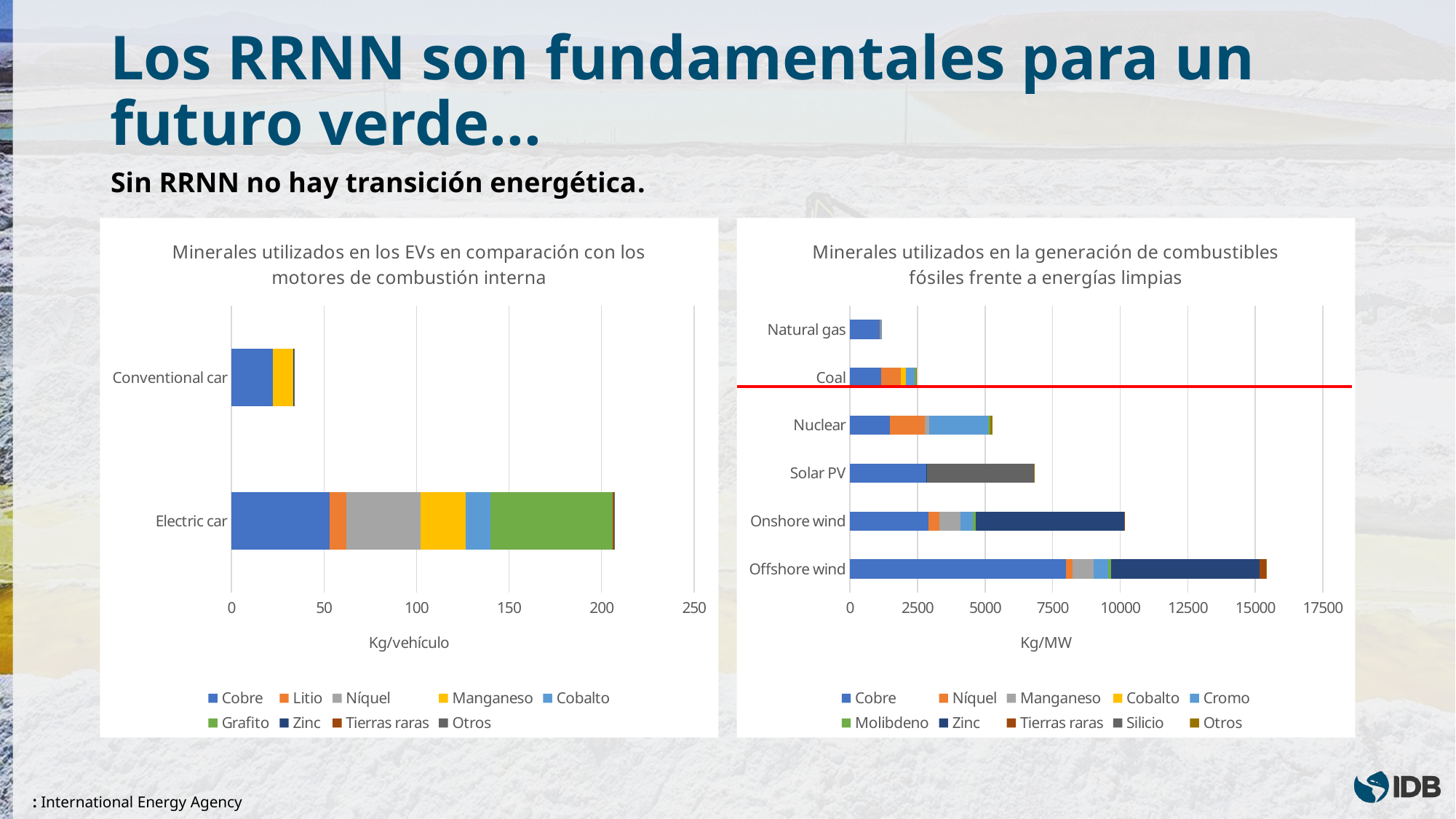
What kind of chart is the left chart, 'Minerales utilizados en los EVs en comparación con los motores de combustión interna'? Bar chart In the left chart, is the total value for Conventional car greater or less than 50? less In the left chart, which category has the larger total bar? Electric car In the right chart, how many series does the legend list? 10 In the left chart, is the total value for Electric car greater or less than 150? greater In the left chart, how many series does the legend list? 9 In the right chart, what unit is shown on the x axis? Kg/MW In the right chart, is the total value for Solar PV greater or less than 5000? greater In the left chart, how many vehicle categories are plotted? 2 In the right chart, which category has the lowest total bar? Natural gas In the right chart, 'Minerales utilizados en la generación de combustibles fósiles frente a energías limpias', how many energy source categories are plotted? 6 In the right chart, which category has the highest total bar? Offshore wind